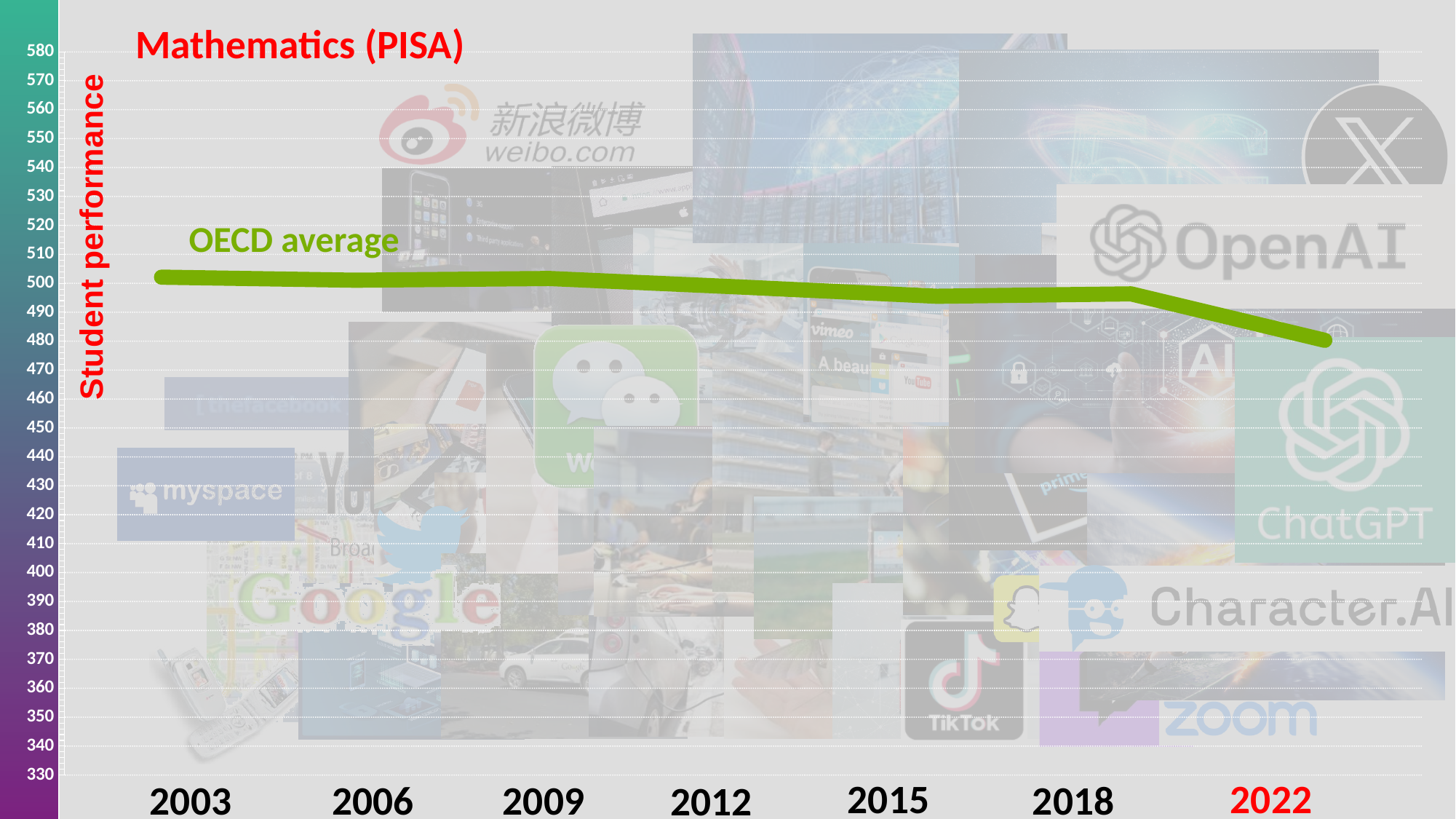
What does the green line on the chart represent? OECD average In which year is the OECD average mathematics score highest? 2003 Is the OECD average value for 2022 greater or less than 490? less Which year has the larger OECD average score, 2009 or 2022? 2009 Is the OECD average value for 2003 greater or less than 490? greater What is the title of the chart? Mathematics (PISA) Which year has the larger OECD average score, 2003 or 2022? 2003 What kind of chart is shown on the slide? line chart In which year is the OECD average mathematics score lowest? 2022 Do the OECD average values rise or fall from 2003 to 2022? fall Is the OECD average value for 2018 greater or less than 480? greater How many years are plotted along the x axis? 7